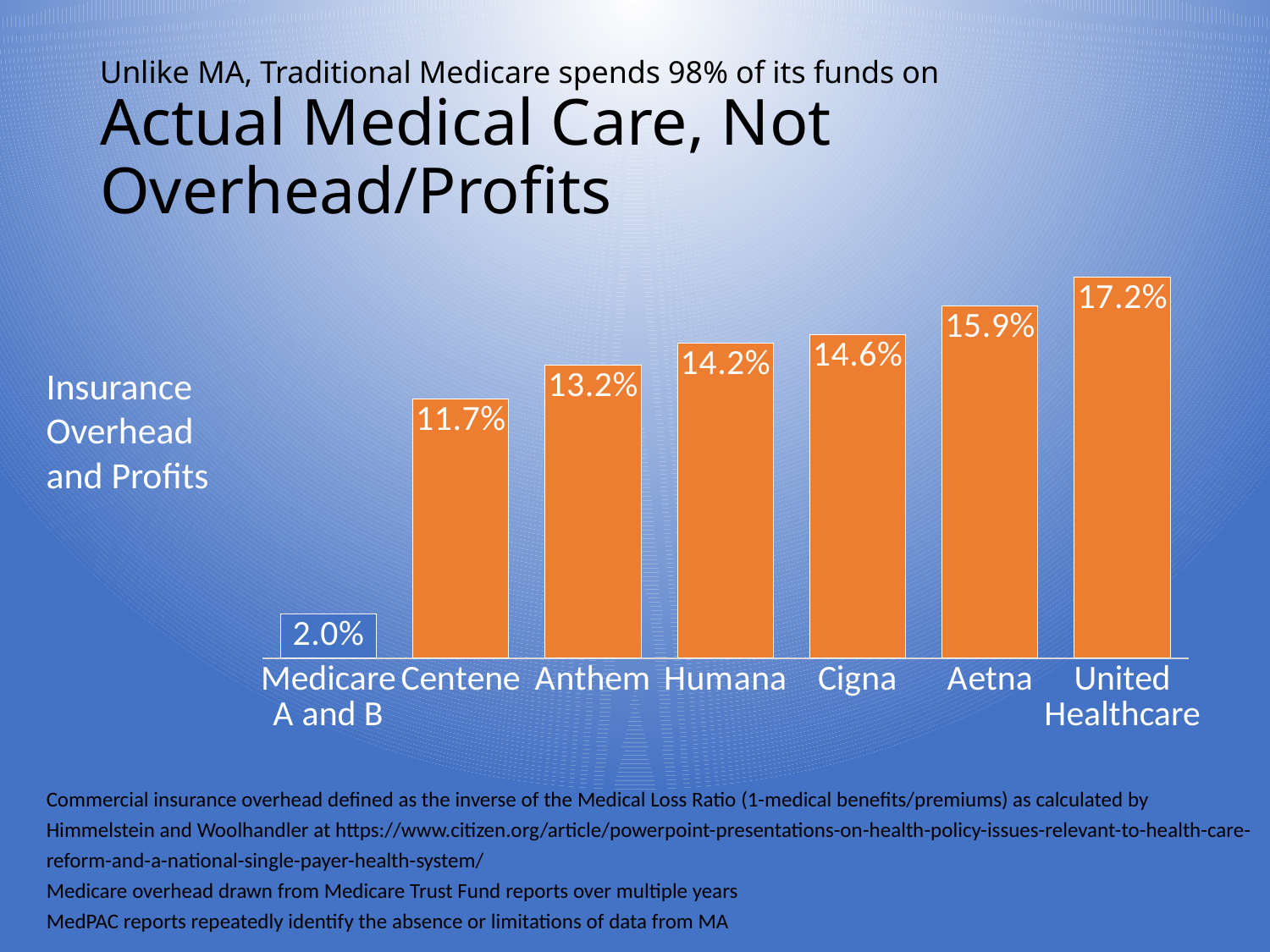
Which has a larger value, Aetna or Humana? Aetna What is the difference between the values for United Healthcare and Medicare A and B? 15.2% What is the value shown for Humana? 14.2% What is the difference between the values for Cigna and Anthem? 1.4% Which category has the lowest insurance overhead and profits value? Medicare A and B What is the insurance overhead and profits value for Medicare A and B? 2.0% How many categories are shown on the x axis of the chart? 7 Do the values rise or fall moving from left to right along the x axis? Rise What is the value shown for Centene? 11.7% Which category has the highest insurance overhead and profits value? United Healthcare What kind of chart is shown on the slide? Bar chart What is the value shown for Aetna? 15.9%